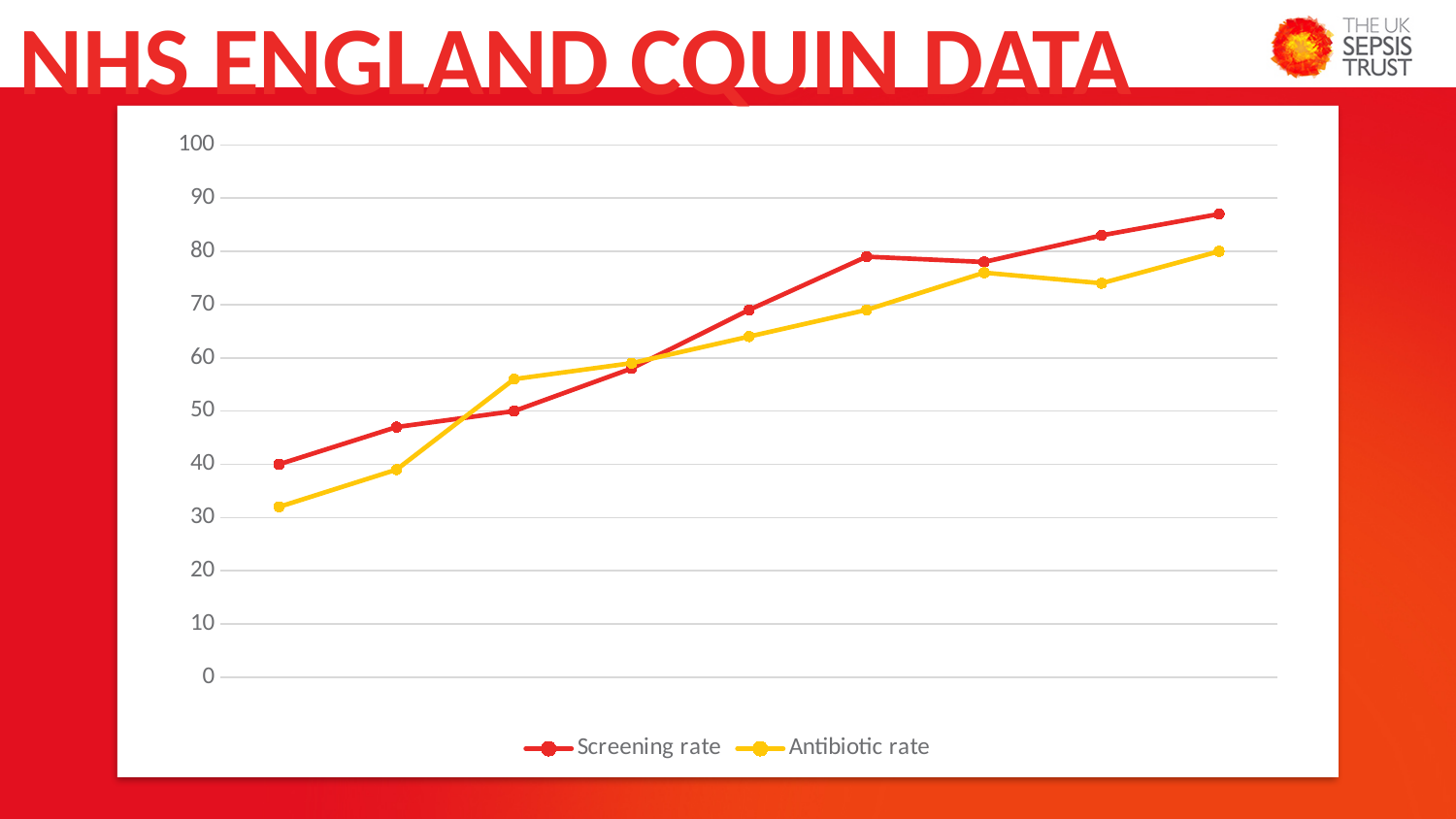
At the first data point, which series has the higher value, Screening rate or Antibiotic rate? Screening rate Do the Antibiotic rate values generally rise or fall from left to right? rise Is the last Screening rate value greater or less than 80? greater At the last data point, which series has the higher value, Screening rate or Antibiotic rate? Screening rate How many data points does the Screening rate line have? 9 What are the two series named in the legend? Screening rate and Antibiotic rate What kind of chart is shown on the slide? line chart Do the Screening rate values generally rise or fall from left to right? rise Is the first Antibiotic rate value greater or less than 40? less Which colour is used for the Antibiotic rate line? yellow Is the last Antibiotic rate value greater or less than 90? less How many series does the legend list? 2